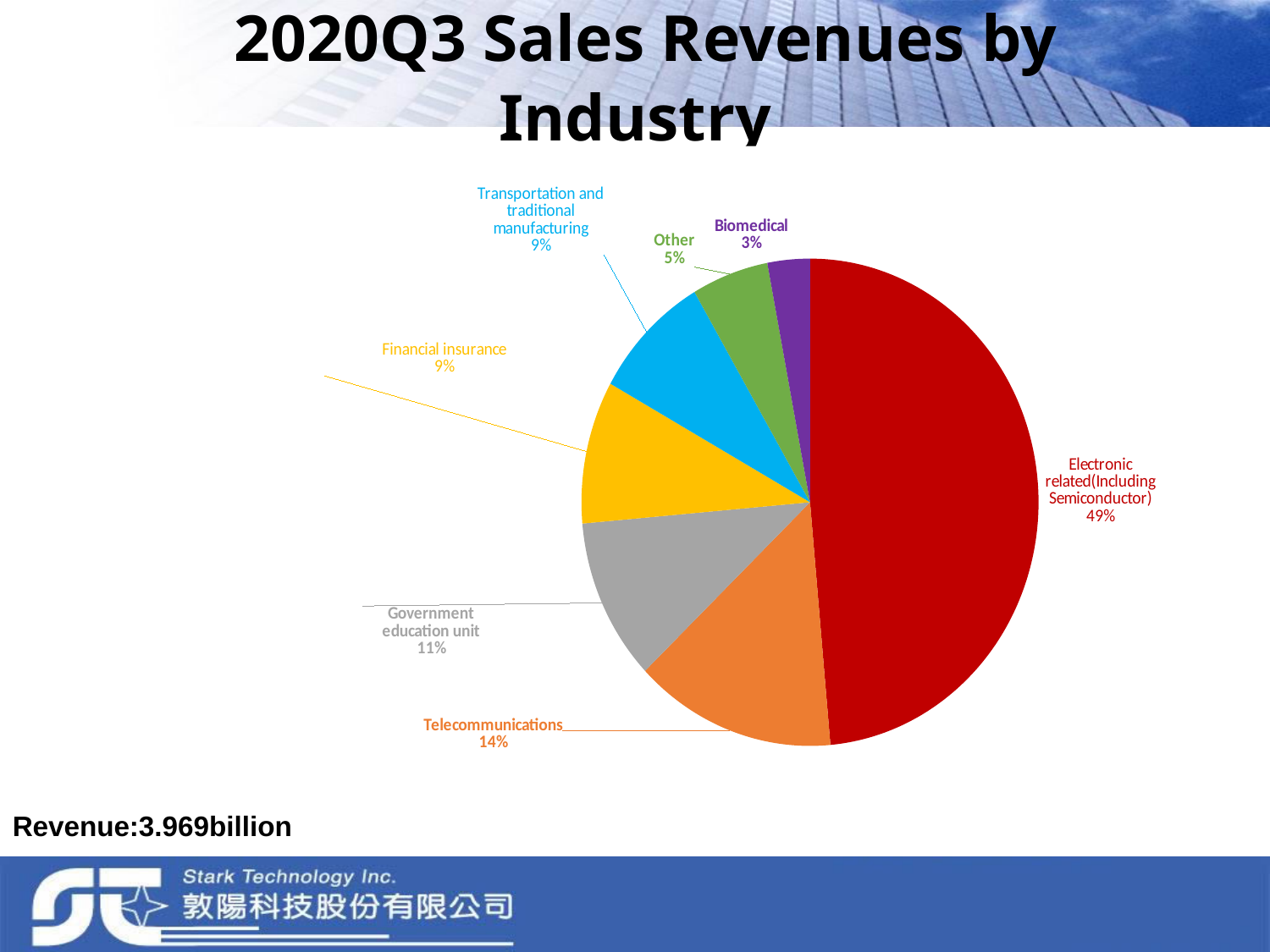
How many industry categories are shown in the pie chart? 7 What share of 2020Q3 sales revenues comes from Government education unit? 11% Which industry has the smallest share of 2020Q3 sales revenues? Biomedical Which industry has the largest share of 2020Q3 sales revenues? Electronic related(Including Semiconductor) Which has a larger share, Financial insurance or Other? Financial insurance What share of 2020Q3 sales revenues comes from Electronic related (Including Semiconductor)? 49% What is the difference in share between Telecommunications and Government education unit? 3% What kind of chart is shown on the slide? Pie chart What share of 2020Q3 sales revenues comes from Other? 5% What is the title of the chart on the slide? 2020Q3 Sales Revenues by Industry